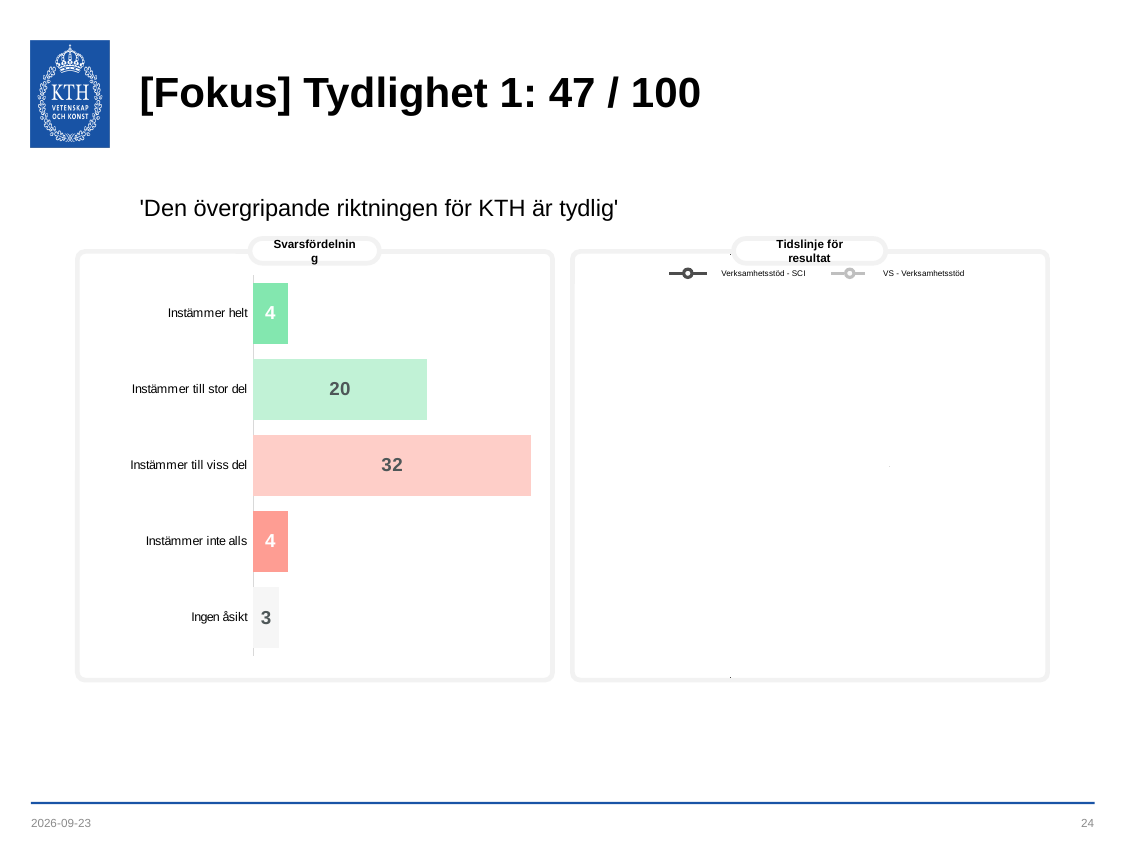
What is the total of all values in the 'Svarsfördelning' chart? 63 In the 'Svarsfördelning' chart, what is the value for 'Instämmer till viss del'? 32 What kind of chart is the 'Svarsfördelning' chart? Bar chart How many series does the legend of the 'Tidslinje för resultat' chart list? 2 In the 'Svarsfördelning' chart, which is larger: 'Instämmer till stor del' or 'Instämmer inte alls'? Instämmer till stor del In the 'Svarsfördelning' chart, what is the value for 'Instämmer till stor del'? 20 In the 'Svarsfördelning' chart, what is the value for 'Instämmer helt'? 4 In the 'Svarsfördelning' chart, what is the value for 'Ingen åsikt'? 3 In the 'Svarsfördelning' chart, which category has the lowest value? Ingen åsikt In the 'Svarsfördelning' chart, what is the difference between 'Instämmer till viss del' and 'Instämmer till stor del'? 12 In the 'Svarsfördelning' chart, which category has the highest value? Instämmer till viss del How many categories are shown in the 'Svarsfördelning' chart? 5